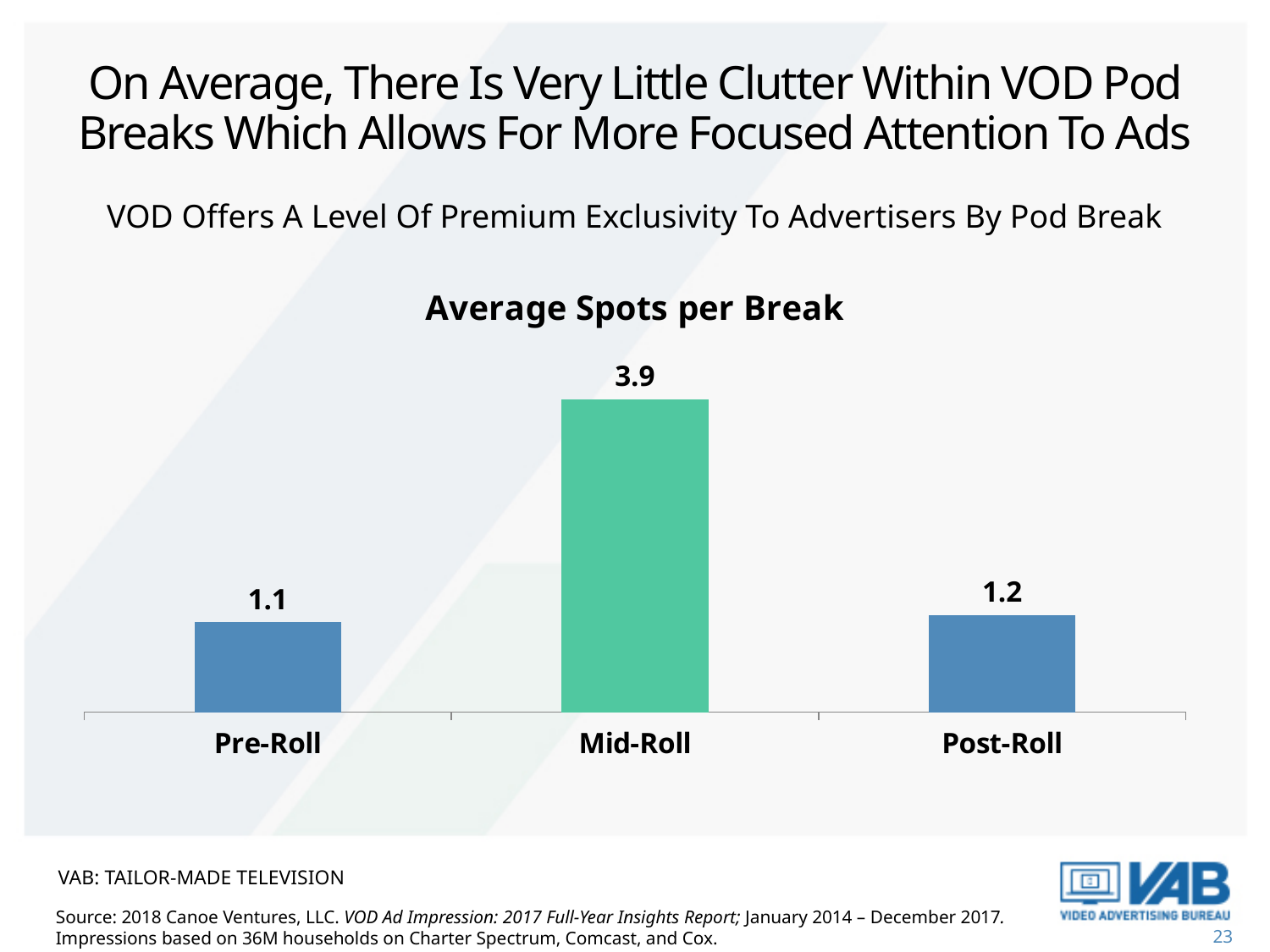
Which pod break type has the highest average spots per break? Mid-Roll What type of chart is used to show average spots per break? Bar chart Which bar in the chart is coloured green rather than blue? Mid-Roll What is the average number of spots per break for Mid-Roll? 3.9 What is the difference in average spots per break between Mid-Roll and Pre-Roll? 2.8 What is the average number of spots per break for Post-Roll? 1.2 How many pod break categories are shown in the chart? 3 Which has more average spots per break, Mid-Roll or Post-Roll? Mid-Roll What is the title of the chart? Average Spots per Break What is the difference in average spots per break between Post-Roll and Pre-Roll? 0.1 What is the average number of spots per break for Pre-Roll? 1.1 Which pod break type has the lowest average spots per break? Pre-Roll